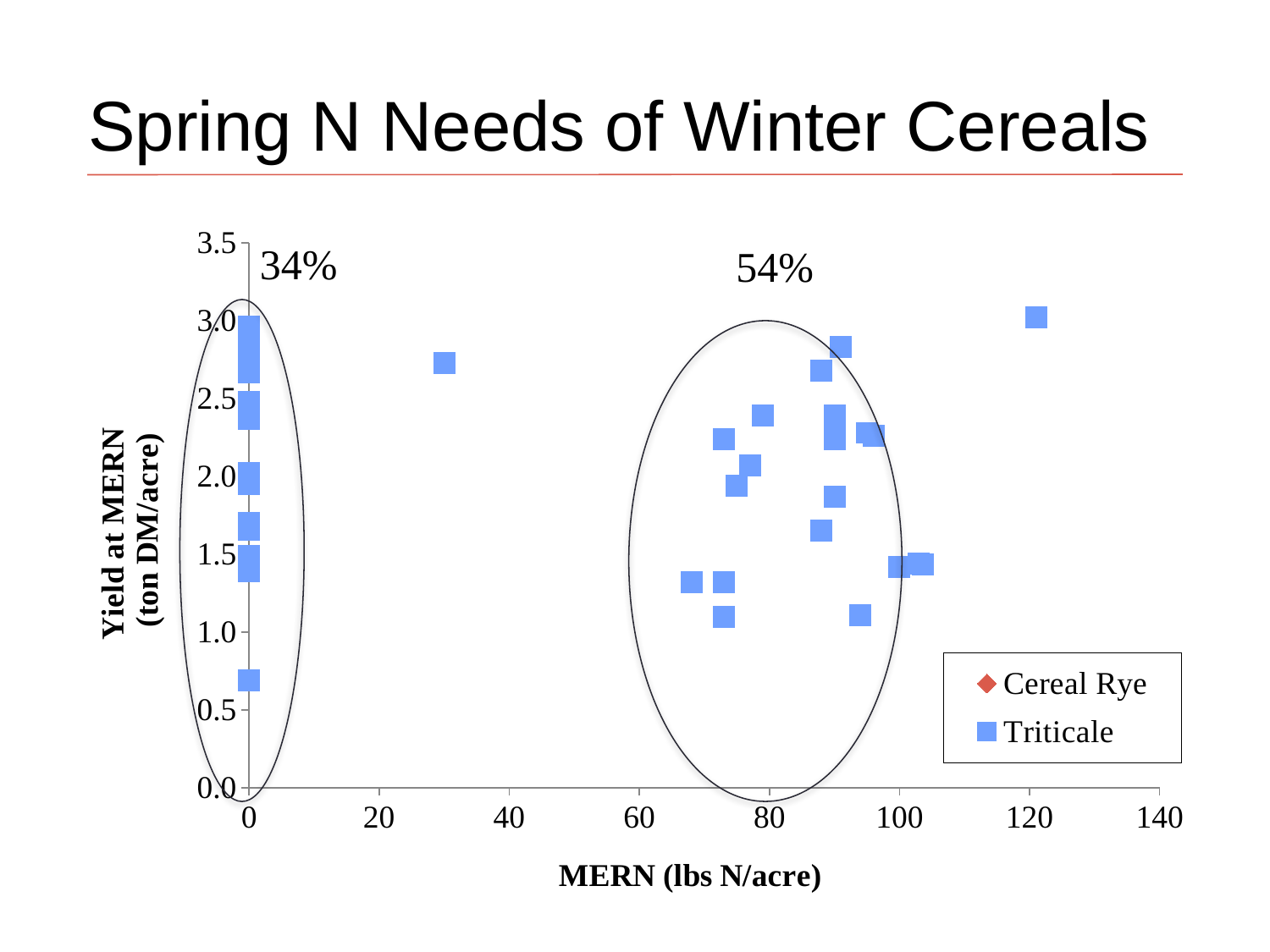
Is the yield of the Triticale point at a MERN of about 30 greater or less than 2.5? greater What percentage is written above the ellipse around the points near MERN of 80? 54% What kind of chart is shown on the slide? scatter chart What are the two series named in the legend? Cereal Rye and Triticale How many series does the legend list? 2 What is the highest value shown on the y axis? 3.5 What is the label of the y axis? Yield at MERN (ton DM/acre) What is the title of the slide's chart? Spring N Needs of Winter Cereals What is the label of the x axis? MERN (lbs N/acre) What percentage is written above the ellipse around the points at MERN of 0? 34% What is the highest value shown on the x axis? 140 Is the MERN value of the rightmost Triticale point greater or less than 100? greater